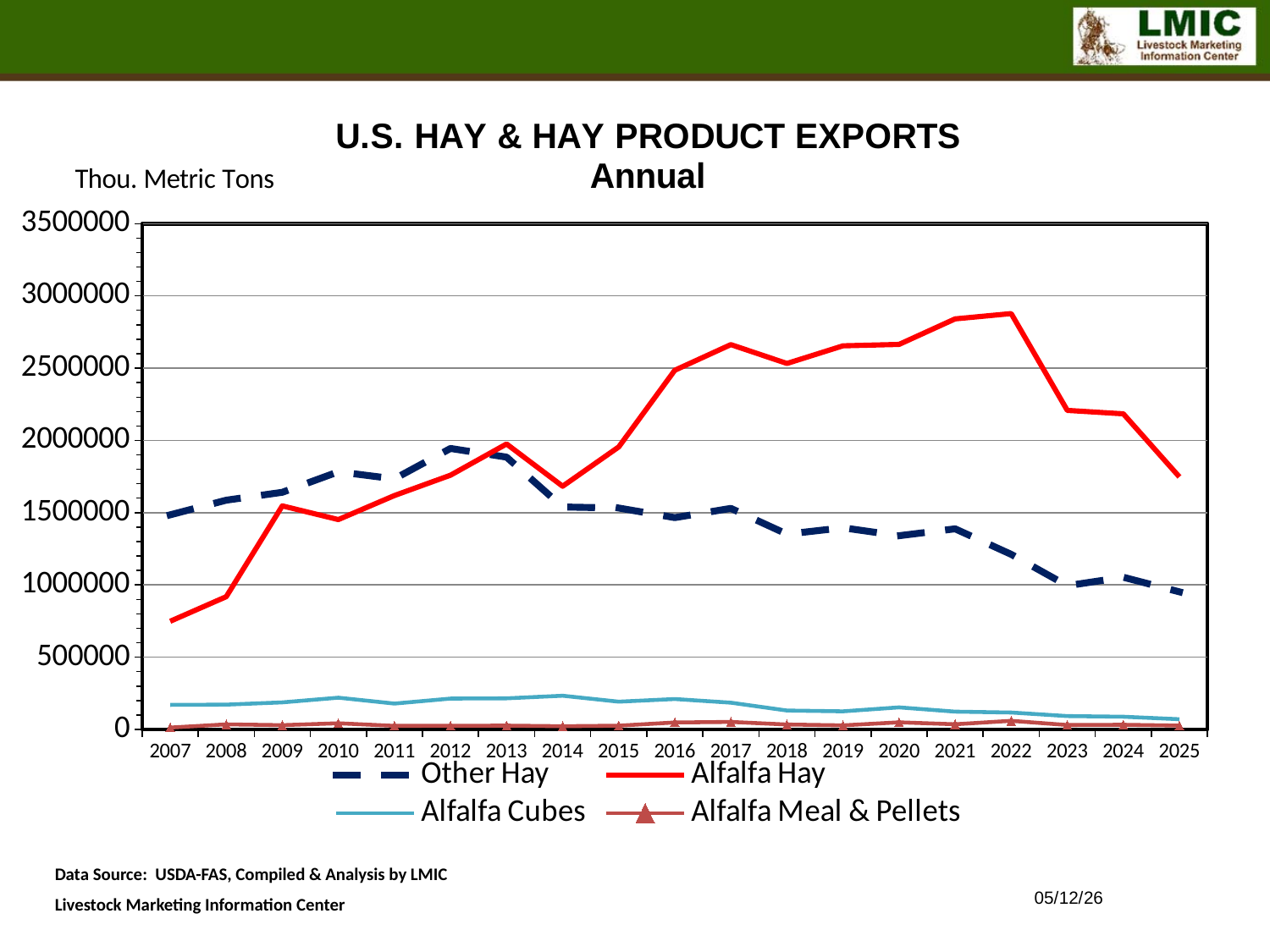
Is the value for Other Hay in 2012 greater or less than 1500000? greater Is the value for Alfalfa Hay in 2007 greater or less than 1000000? less In 2010, which is larger: Other Hay or Alfalfa Hay? Other Hay In which year is Alfalfa Hay at its lowest? 2007 Is the value for Alfalfa Cubes in 2014 greater or less than 500000? less Do the values for Alfalfa Hay rise or fall from 2022 to 2025? fall Which series has the highest value in 2025? Alfalfa Hay What unit is given for the y axis? Thou. Metric Tons How many series does the legend list? 4 What kind of chart is shown on the slide? line chart How many years are plotted along the x axis? 19